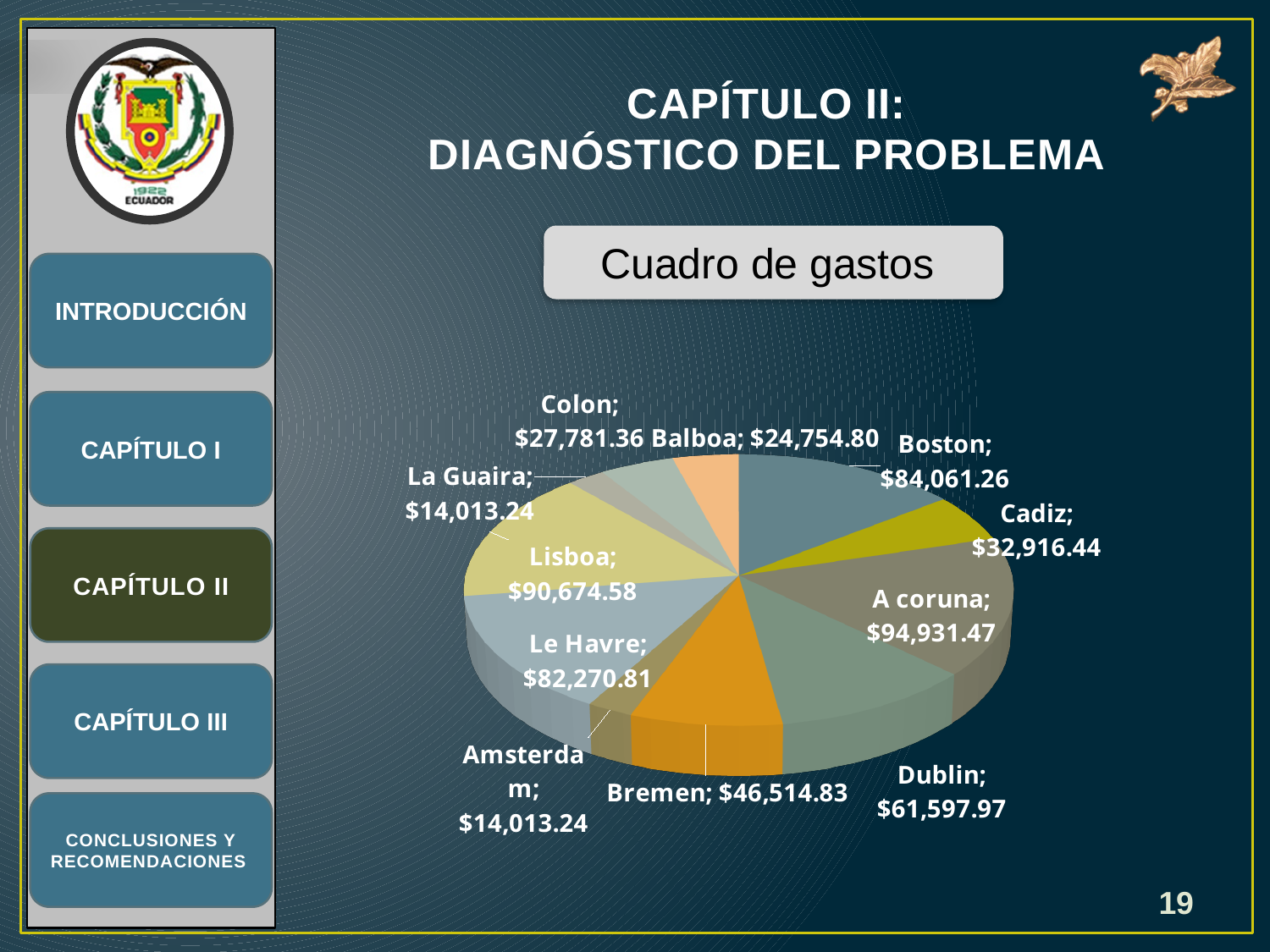
What is the value for Balboa? $24,754.80 What is the difference between the values for A coruna and Lisboa? $4,256.89 What is the value for Cadiz? $32,916.44 What kind of chart is shown on the slide? pie chart How many slices does the pie chart have? 11 What is the difference between the values for Dublin and Bremen? $15,083.14 What is the value for A coruna? $94,931.47 Which category has the highest value? A coruna What is the title shown above the chart? Cuadro de gastos Which is larger, the value for Dublin or the value for Colon? Dublin Which is larger, the value for Boston or the value for Le Havre? Boston What is the value for Bremen? $46,514.83